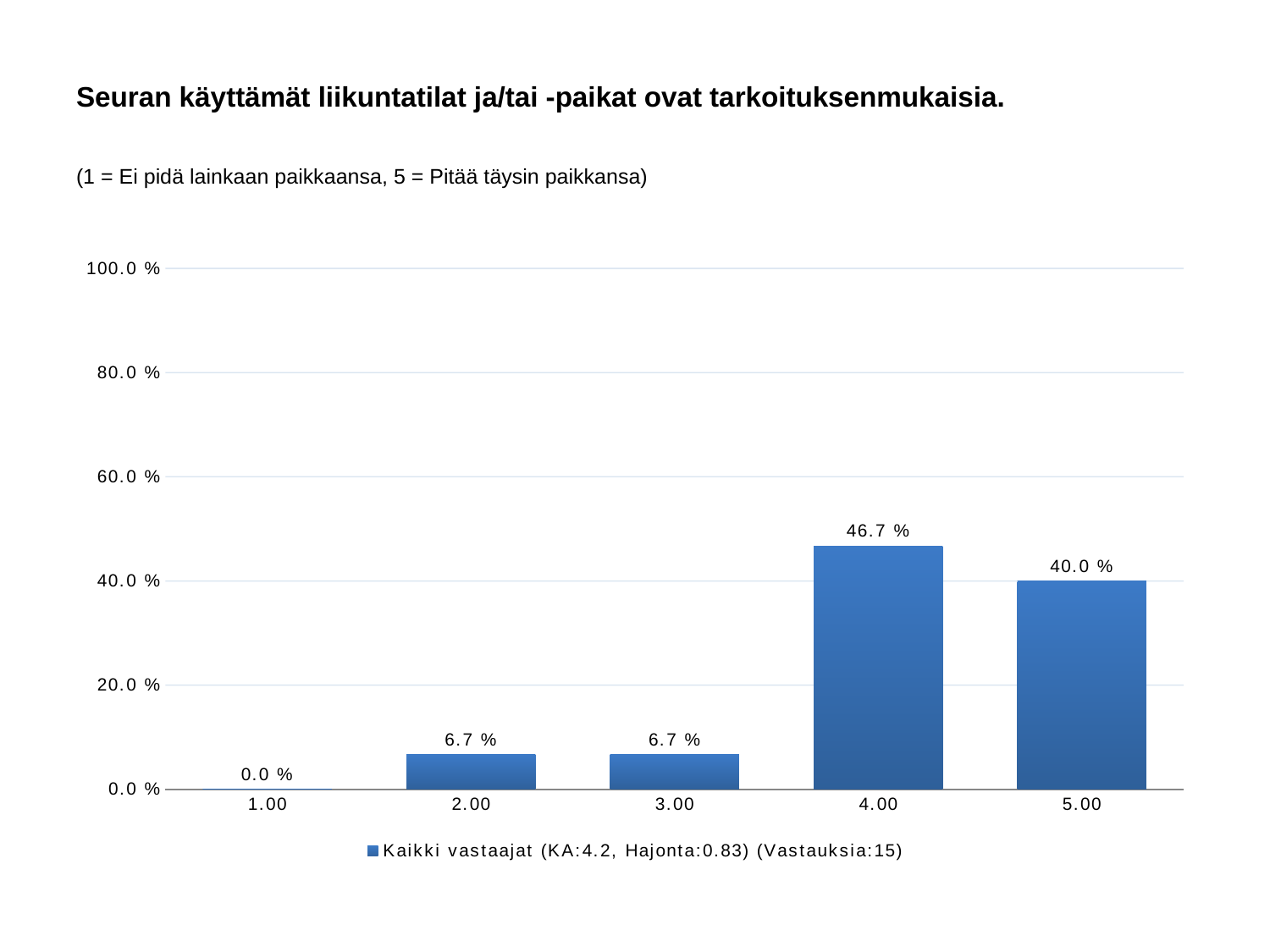
Which category has the highest value? 4.00 What is the difference between the values for 4.00 and 5.00? 6.7 % What is the value for category 5.00? 40.0 % How many categories are shown on the x axis? 5 How many series does the legend list? 1 Is the value for 4.00 greater or less than 40.0 %? greater What is the value for category 4.00? 46.7 % What is the number of responses (Vastauksia) given in the legend? 15 What is the value for category 1.00? 0.0 % What kind of chart is shown? bar chart Which category has the lowest value? 1.00 Which is larger, the value for 2.00 or the value for 5.00? 5.00